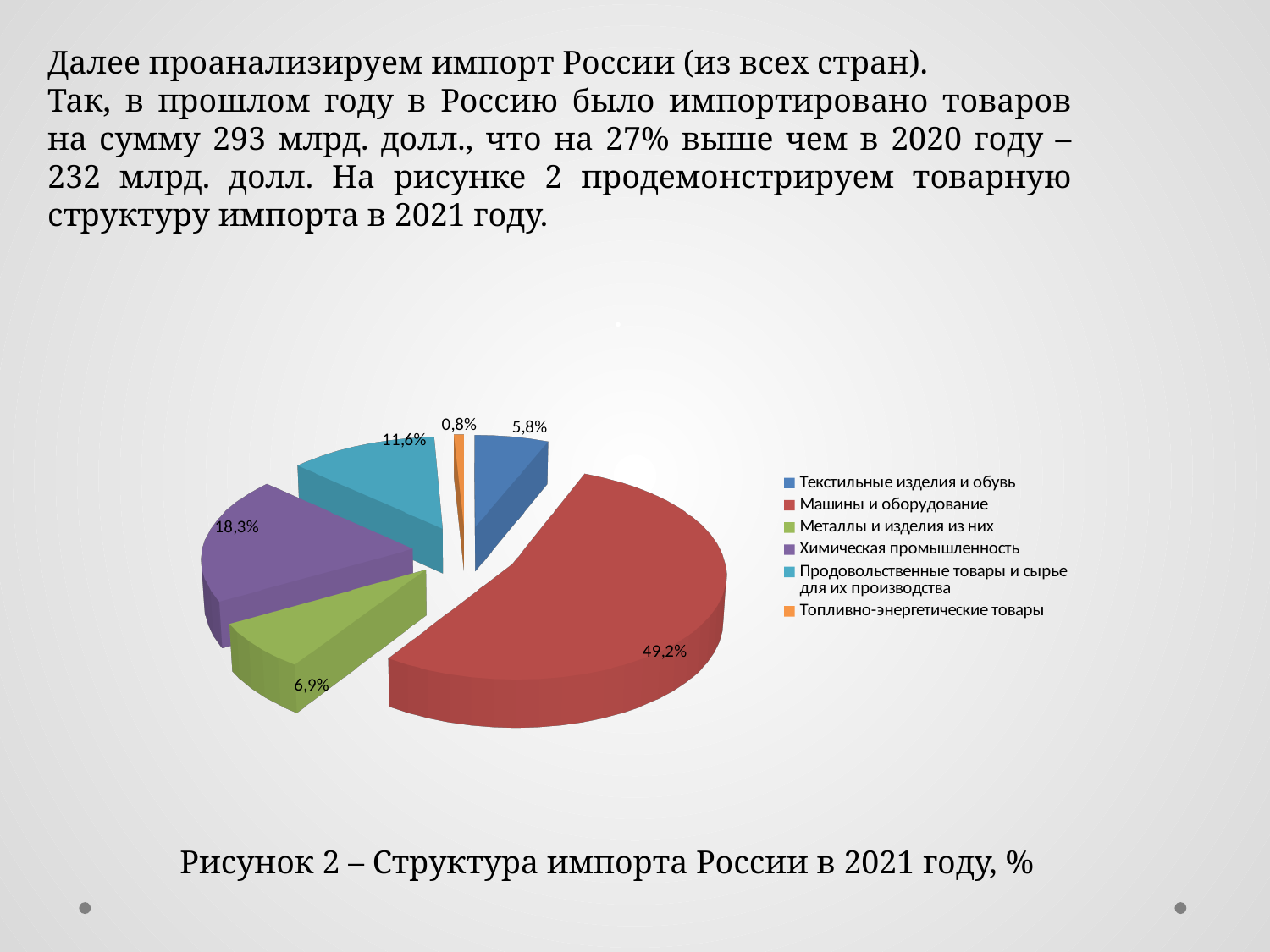
Which category has the smallest share of imports? Топливно-энергетические товары Which has a larger share: Металлы и изделия из них or Текстильные изделия и обувь? Металлы и изделия из них What share of imports is Химическая промышленность? 18,3% What is the title of the chart (Рисунок 2)? Структура импорта России в 2021 году, % What share of imports is Текстильные изделия и обувь? 5,8% Which category has the largest share of imports? Машины и оборудование What share of imports is Топливно-энергетические товары? 0,8% What share of imports is Продовольственные товары и сырье для их производства? 11,6% What share of Russia's 2021 imports is Машины и оборудование? 49,2% What kind of chart is shown on the slide? Pie chart What is the difference between the shares of Химическая промышленность and Металлы и изделия из них? 11,4% How many categories does the pie chart show? 6